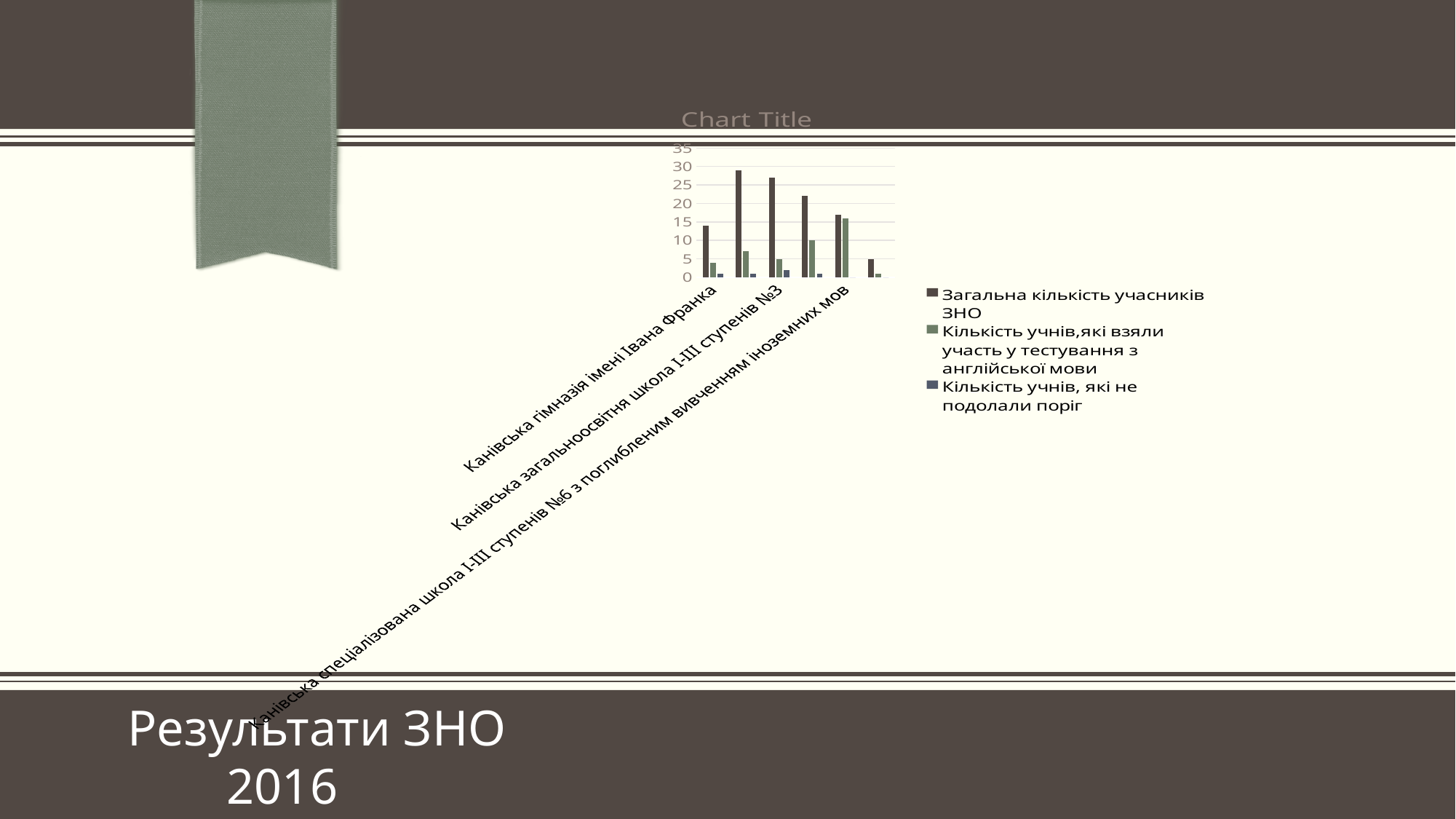
Is the value of "Загальна кількість учасників ЗНО" for Канівська гімназія імені Івана Франка greater or less than 20? less What is the title shown above the chart? Chart Title How many groups of bars are plotted in the chart? 6 Is the value of "Загальна кількість учасників ЗНО" for Канівська загальноосвітня школа I-III ступенів №3 greater or less than 20? greater For Канівська загальноосвітня школа I-III ступенів №3, which is larger: "Загальна кількість учасників ЗНО" or "Кількість учнів,які взяли участь у тестування з англійської мови"? Загальна кількість учасників ЗНО What kind of chart is shown on the slide? bar chart Is the value of "Кількість учнів,які взяли участь у тестування з англійської мови" for Канівська гімназія імені Івана Франка greater or less than 10? less For Канівська гімназія імені Івана Франка, which is larger: "Загальна кількість учасників ЗНО" or "Кількість учнів, які не подолали поріг"? Загальна кількість учасників ЗНО Which legend entry is shown with the dark brown colour? Загальна кількість учасників ЗНО How many series does the chart legend list? 3